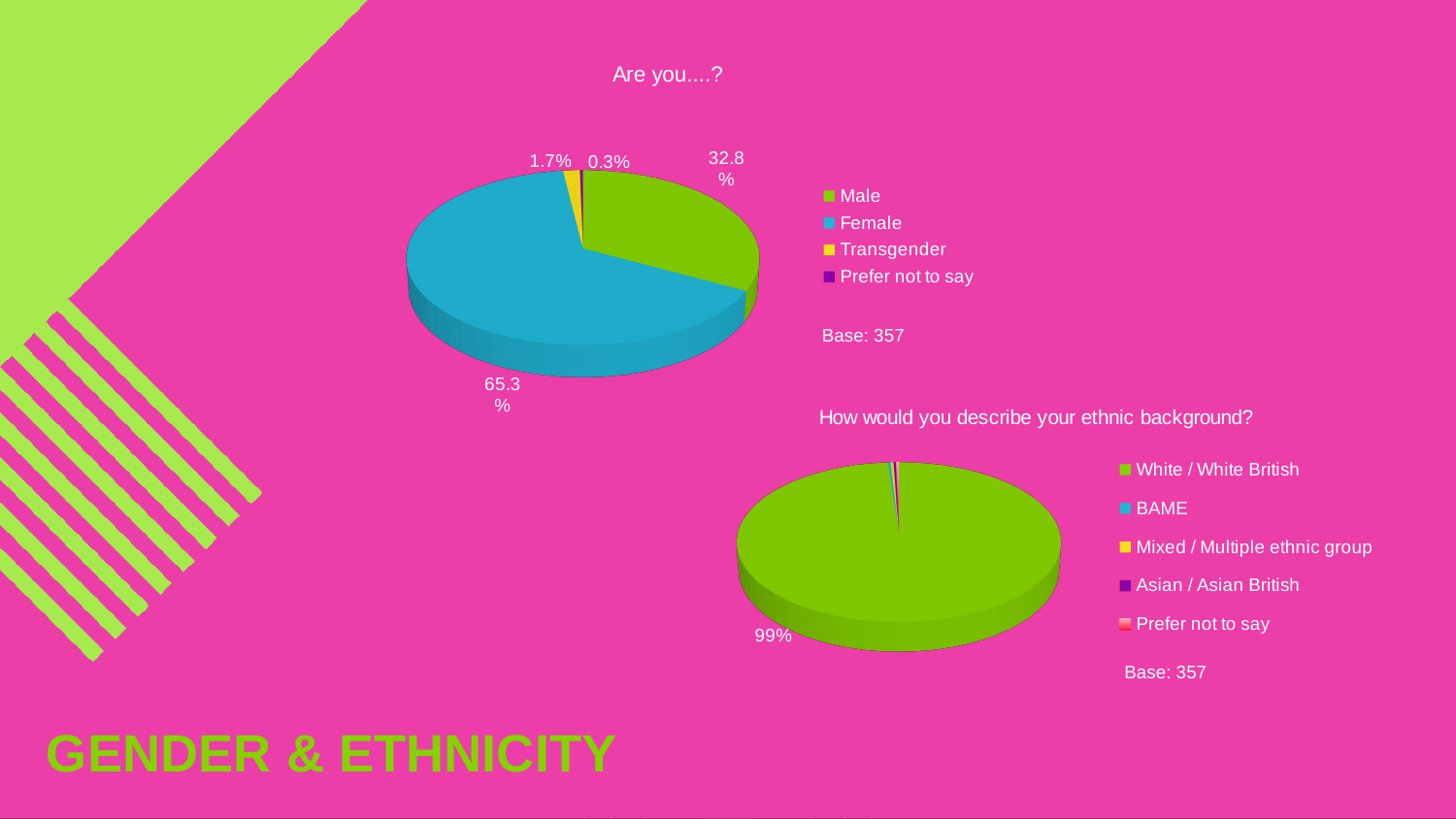
In the 'Are you....?' chart, what percentage of respondents are Transgender? 1.7% What type of chart is used for 'How would you describe your ethnic background?'? Pie chart In the 'Are you....?' chart, what percentage of respondents are Female? 65.3% In the 'How would you describe your ethnic background?' chart, what percentage of respondents are White / White British? 99% In the 'Are you....?' chart, how many categories does the legend list? 4 In the 'Are you....?' chart, what is the difference in percentage points between Female and Male? 32.5 In the 'Are you....?' chart, what percentage of respondents chose 'Prefer not to say'? 0.3% In the 'Are you....?' chart, which category has the smallest share? Prefer not to say In the 'Are you....?' chart, which category has the largest share? Female In the 'Are you....?' chart, what percentage of respondents are Male? 32.8% What is the base (number of respondents) shown for the 'Are you....?' chart? 357 In the 'How would you describe your ethnic background?' chart, how many categories does the legend list? 5